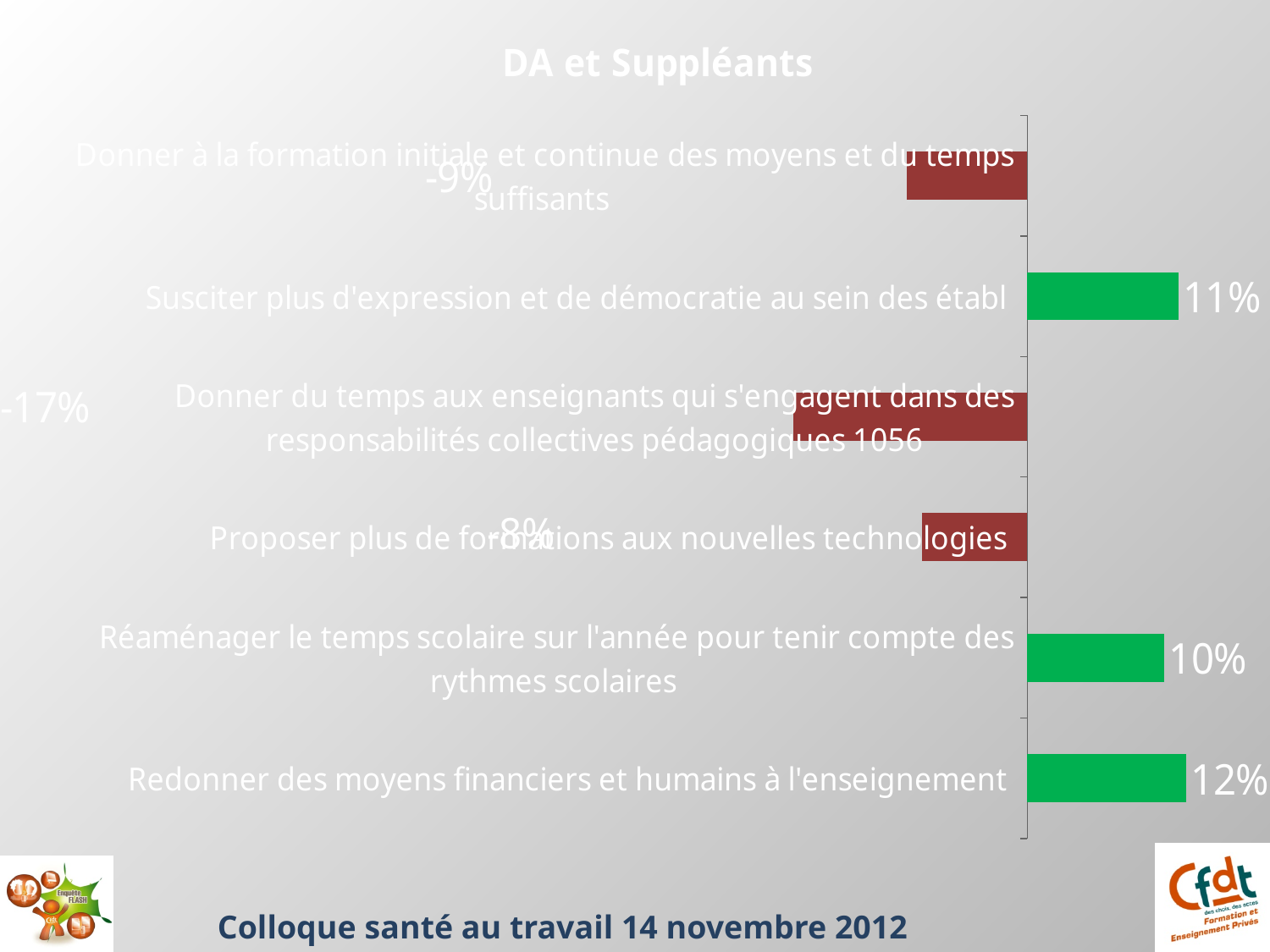
What is the difference between the values for "Redonner des moyens financiers et humains à l'enseignement" and "Réaménager le temps scolaire sur l'année pour tenir compte des rythmes scolaires"? 2% What kind of chart is shown on the slide? bar chart What is the title of the chart? DA et Suppléants Which is larger: the value for "Susciter plus d'expression et de démocratie au sein des établ" or the value for "Réaménager le temps scolaire sur l'année pour tenir compte des rythmes scolaires"? Susciter plus d'expression et de démocratie au sein des établ What is the value for "Redonner des moyens financiers et humains à l'enseignement"? 12% What is the value for "Susciter plus d'expression et de démocratie au sein des établ"? 11% What is the value for "Réaménager le temps scolaire sur l'année pour tenir compte des rythmes scolaires"? 10% How many categories are plotted in the chart? 6 Which category has the highest value? Redonner des moyens financiers et humains à l'enseignement Which category has the lowest value? Donner du temps aux enseignants qui s'engagent dans des responsabilités collectives pédagogiques What is the value for "Donner à la formation initiale et continue des moyens et du temps suffisants"? -9% What is the value for "Donner du temps aux enseignants qui s'engagent dans des responsabilités collectives pédagogiques"? -17%